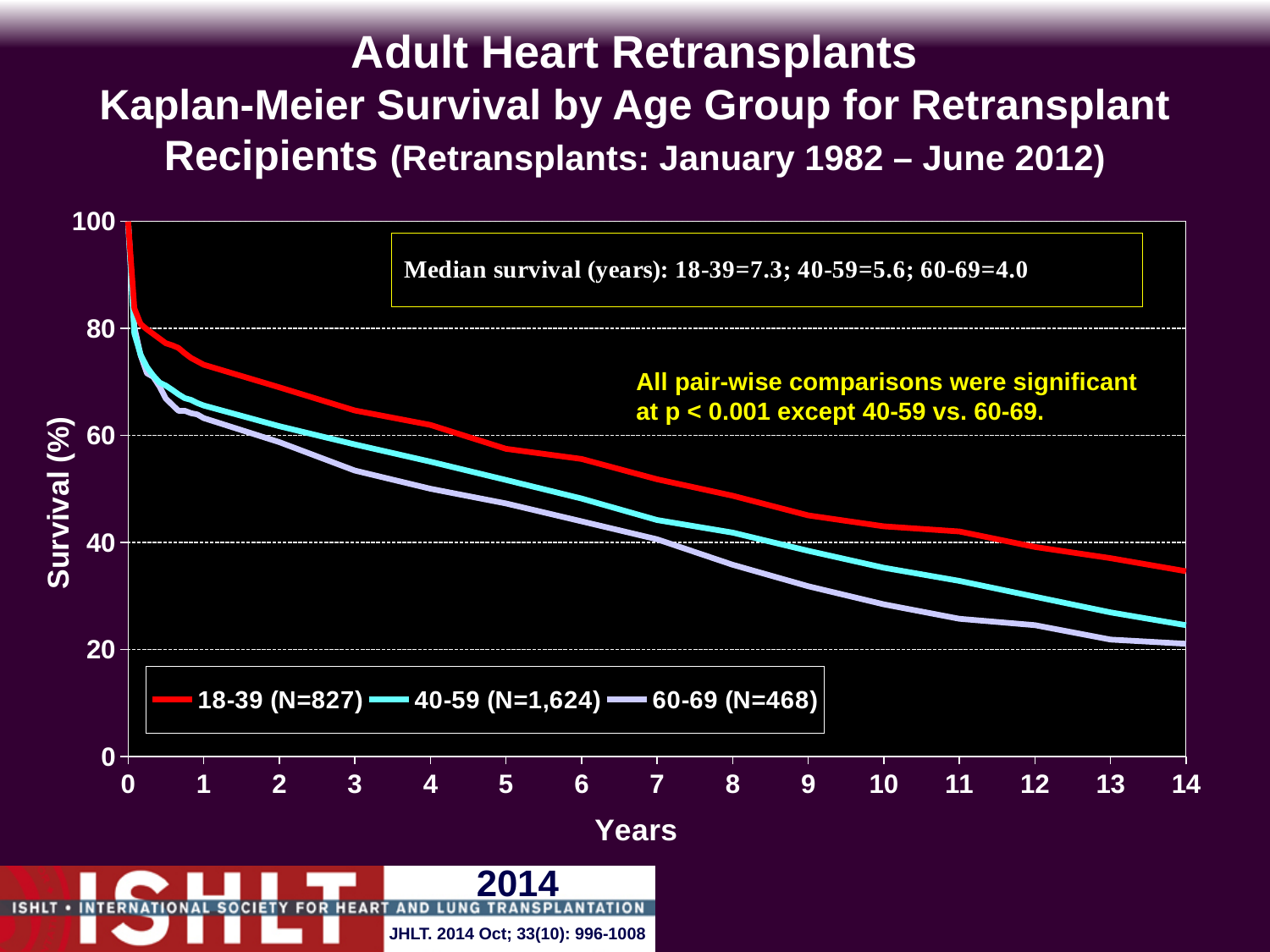
Is the survival value for the 60-69 group at 10 years greater or less than 40? less What kind of chart is shown on the slide? line chart Which age group has the lowest median survival? 60-69 What is the difference in median survival (years) between the 18-39 and 60-69 age groups? 3.3 Is the survival value for the 18-39 group at 14 years greater or less than 40? less Which age group has the highest median survival? 18-39 What is the median survival in years for the 18-39 age group? 7.3 What is the N shown in the legend for the 40-59 age group? 1,624 Which series has higher survival at 5 years, 18-39 or 60-69? 18-39 Do the survival curves rise or fall as years increase? fall What is the median survival in years for the 60-69 age group? 4.0 How many series does the legend list? 3